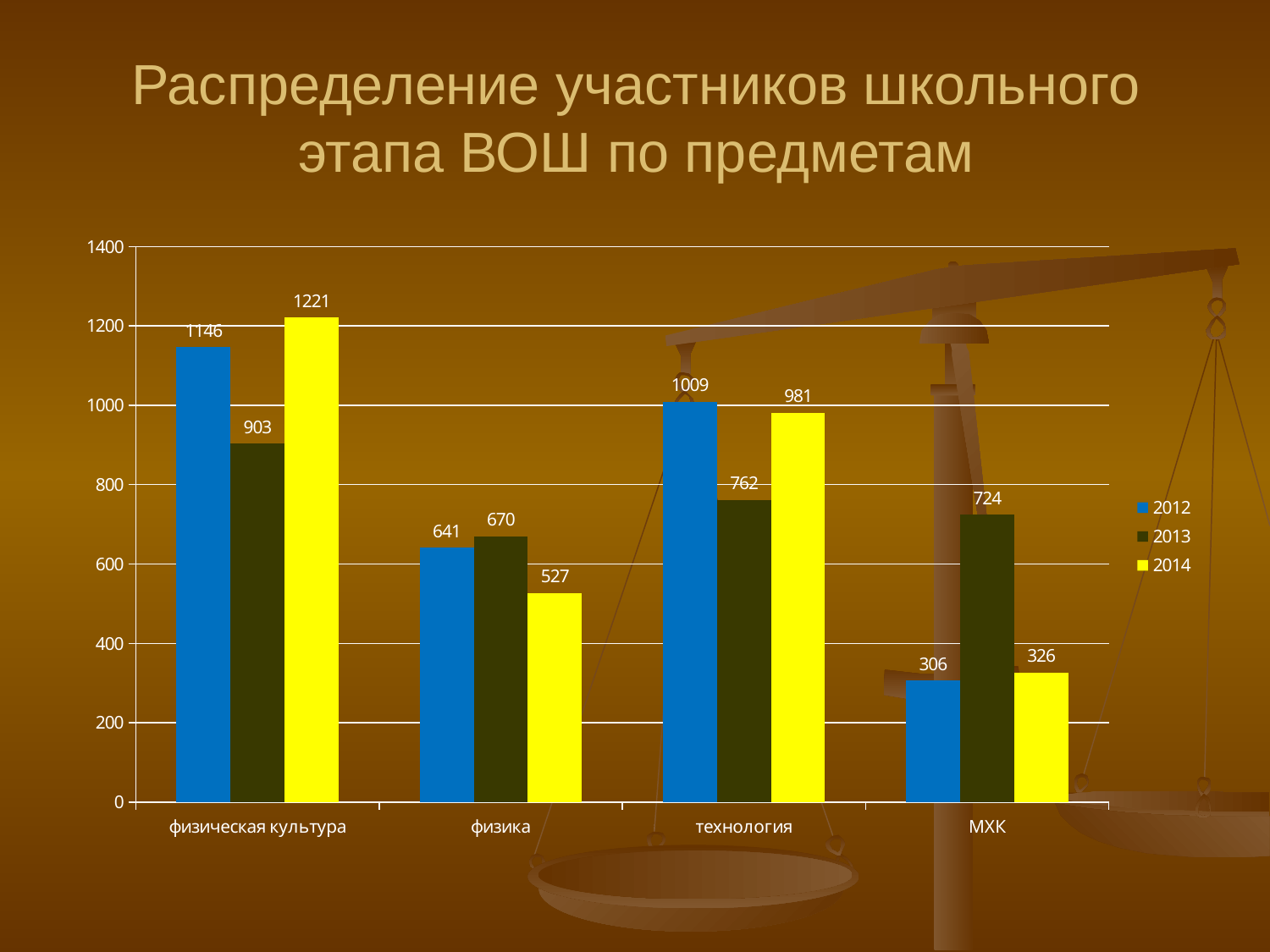
What is the value for физика in 2014? 527 Which is larger for физика: the 2012 value or the 2013 value? 2013 What is the value for физическая культура in 2014? 1221 Is the value for технология in 2014 greater or less than 1000? less What is the value for МХК in 2012? 306 What is the difference between the 2014 and 2012 values for физическая культура? 75 Which category has the highest value in the 2012 series? физическая культура Which category has the lowest value in the 2013 series? физика How many series does the legend list? 3 What kind of chart is shown on the slide? bar chart How many categories are shown on the x axis? 4 What is the value for технология in 2013? 762